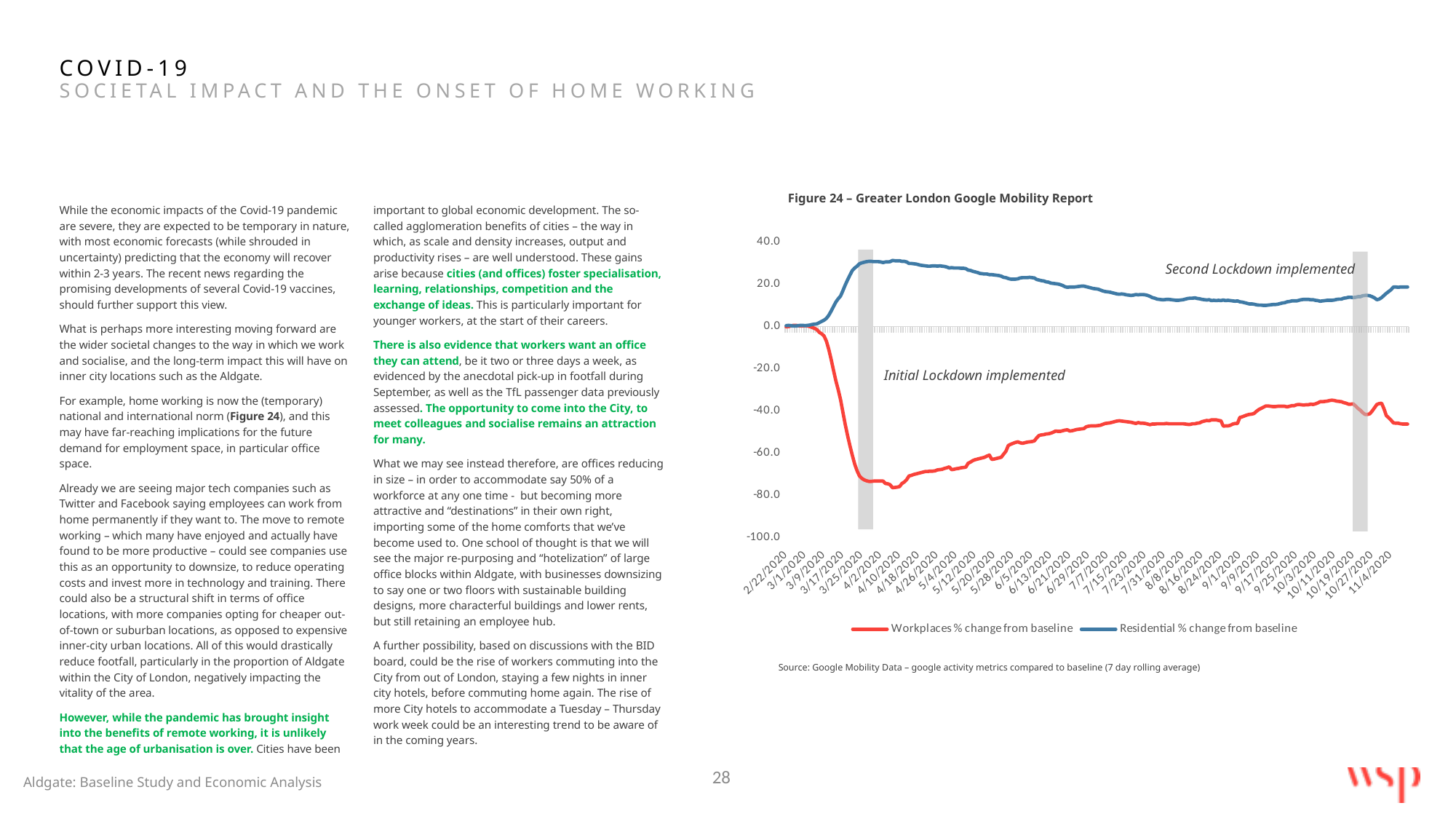
What is the title of the chart on the slide? Figure 24 – Greater London Google Mobility Report At 4/10/2020, which series has the larger value: Workplaces % change from baseline or Residential % change from baseline? Residential % change from baseline Does the Residential % change from baseline series generally rise or fall between 4/2/2020 and 10/3/2020? Fall Is the value for Workplaces % change from baseline at 4/10/2020 greater or less than -60.0? less Is the value for Residential % change from baseline at 11/4/2020 greater or less than 0.0? greater Does the Workplaces % change from baseline series generally rise or fall between 4/10/2020 and 10/11/2020? Rise Is the value for Residential % change from baseline at 4/2/2020 greater or less than 20.0? greater What kind of chart is Figure 24 – Greater London Google Mobility Report? Line chart How many series does the legend of the Greater London Google Mobility Report chart list? 2 Which colour is used for the Workplaces % change from baseline series? Red